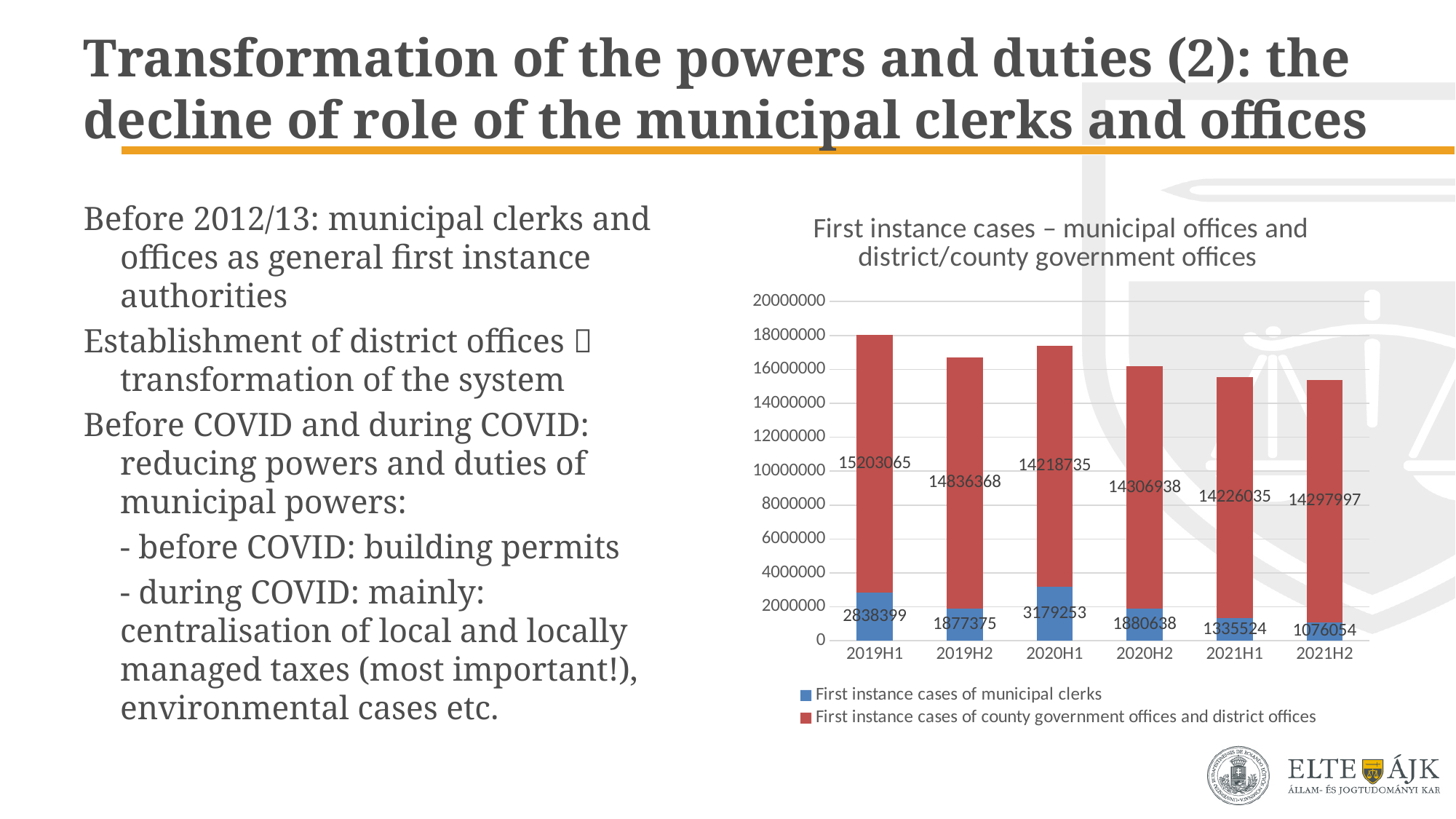
What is the number of first instance cases of municipal clerks in 2021H2? 1076054 In which period is the number of first instance cases of county government offices and district offices highest? 2019H1 What is the difference between the first instance cases of municipal clerks in 2019H1 and 2019H2? 961024 How many time periods are shown on the x axis of the chart? 6 What is the number of first instance cases of county government offices and district offices in 2019H1? 15203065 Is the total height of the stacked bar for 2021H2 greater or less than 16000000? less What is the number of first instance cases of municipal clerks in 2020H1? 3179253 In which period is the number of first instance cases of municipal clerks highest? 2020H1 How many series does the chart legend list? 2 In which period is the number of first instance cases of municipal clerks lowest? 2021H2 What is the total number of first instance cases (both series) in 2019H1? 18041464 What type of chart is shown on the slide? Stacked bar chart